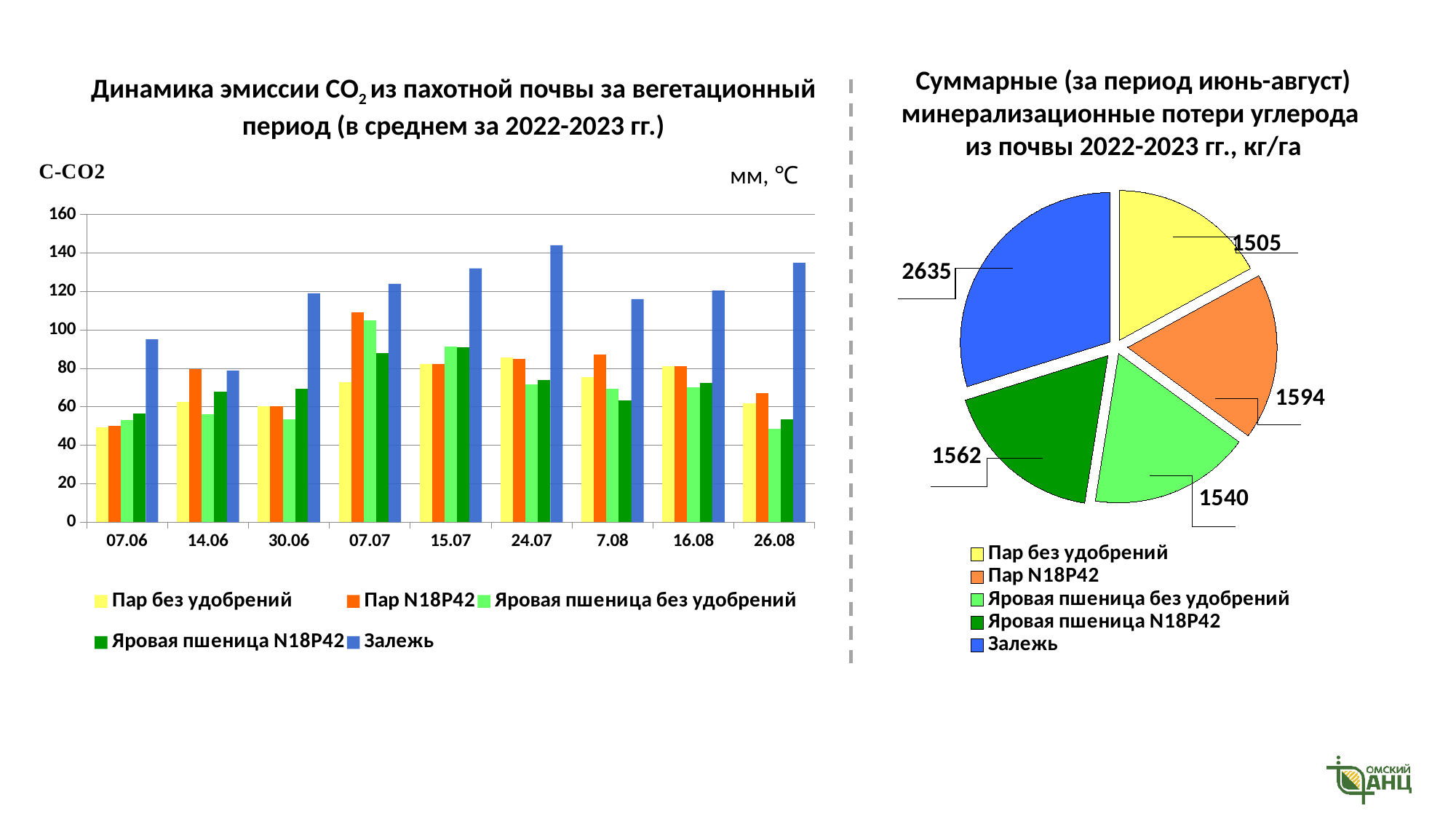
On the pie chart on the right, what is the value for Залежь? 2635 What kind of chart is shown on the left side of the slide? bar chart On the bar chart on the left, how many dates are shown on the x axis? 9 On the pie chart on the right, what is the value for Пар N18P42? 1594 On the pie chart on the right, which category has the smallest value? Пар без удобрений On the pie chart on the right, which is larger: Яровая пшеница N18P42 or Яровая пшеница без удобрений? Яровая пшеница N18P42 On the pie chart on the right, what is the difference between Залежь and Пар без удобрений? 1130 On the bar chart on the left, how many series does the legend list? 5 On the bar chart on the left, is the value for Залежь on 07.06 greater or less than 100? less On the pie chart on the right, how many slices are there? 5 On the pie chart on the right, which category has the largest value? Залежь On the bar chart on the left, is the value for Залежь on 24.07 greater or less than 140? greater